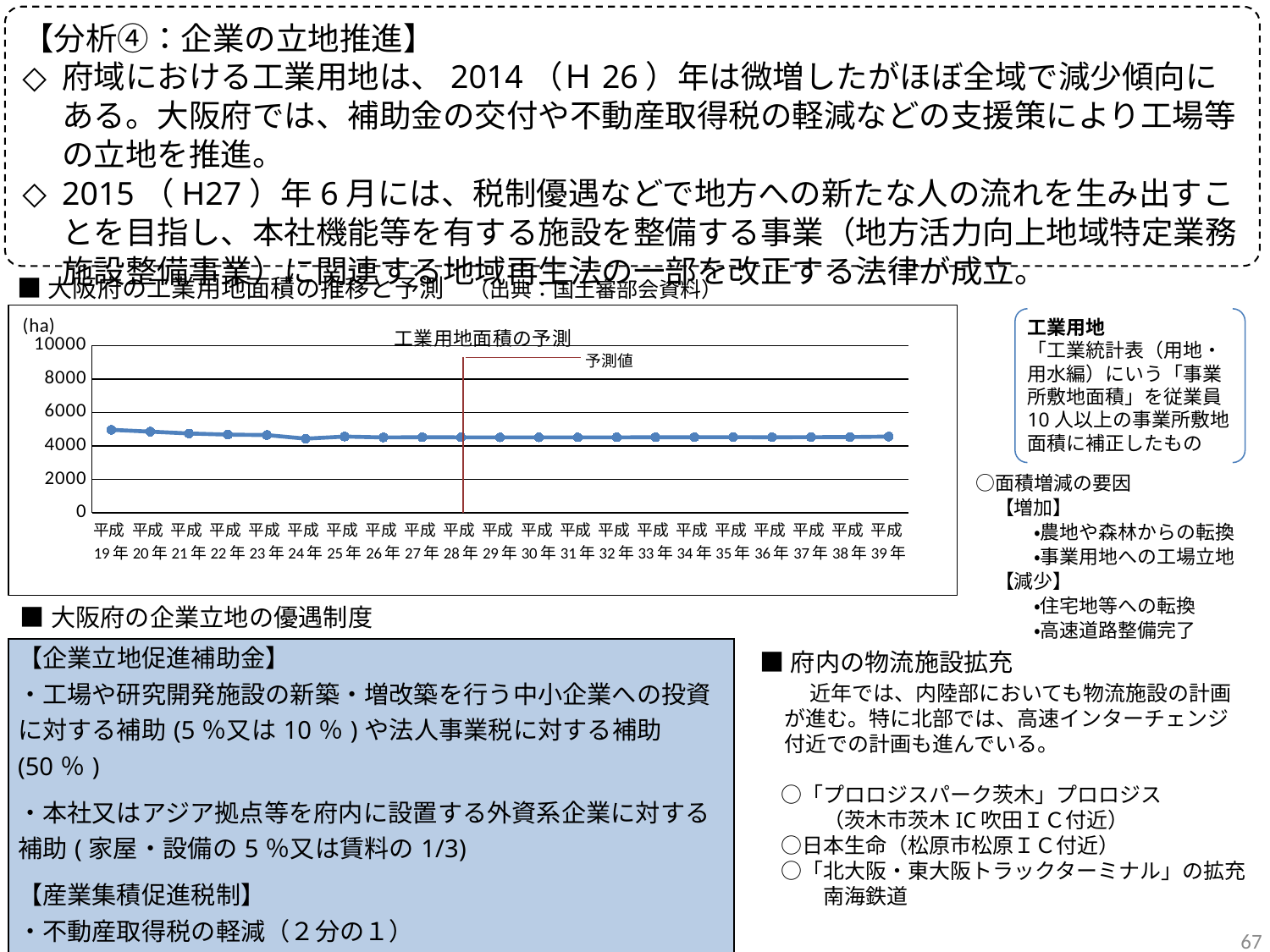
In the 工業用地面積の予測 chart, is the value for 平成30年 greater or less than 2000? greater What is the highest value shown on the y axis of the 工業用地面積の予測 chart? 10000 In the 工業用地面積の予測 chart, is the value for 平成19年 greater or less than 6000? less Do the values in the 工業用地面積の予測 chart generally rise or fall from 平成19年 to 平成39年? fall In the 工業用地面積の予測 chart, is the value for 平成19年 greater or less than 4000? greater What kind of chart is used to show 工業用地面積の予測? line chart What is the title of the line chart on the slide? 工業用地面積の予測 How many data points are plotted in the 工業用地面積の予測 chart? 21 What unit is shown on the y axis of the 工業用地面積の予測 chart? ha In the 工業用地面積の予測 chart, which is larger, the value for 平成19年 or the value for 平成39年? 平成19年